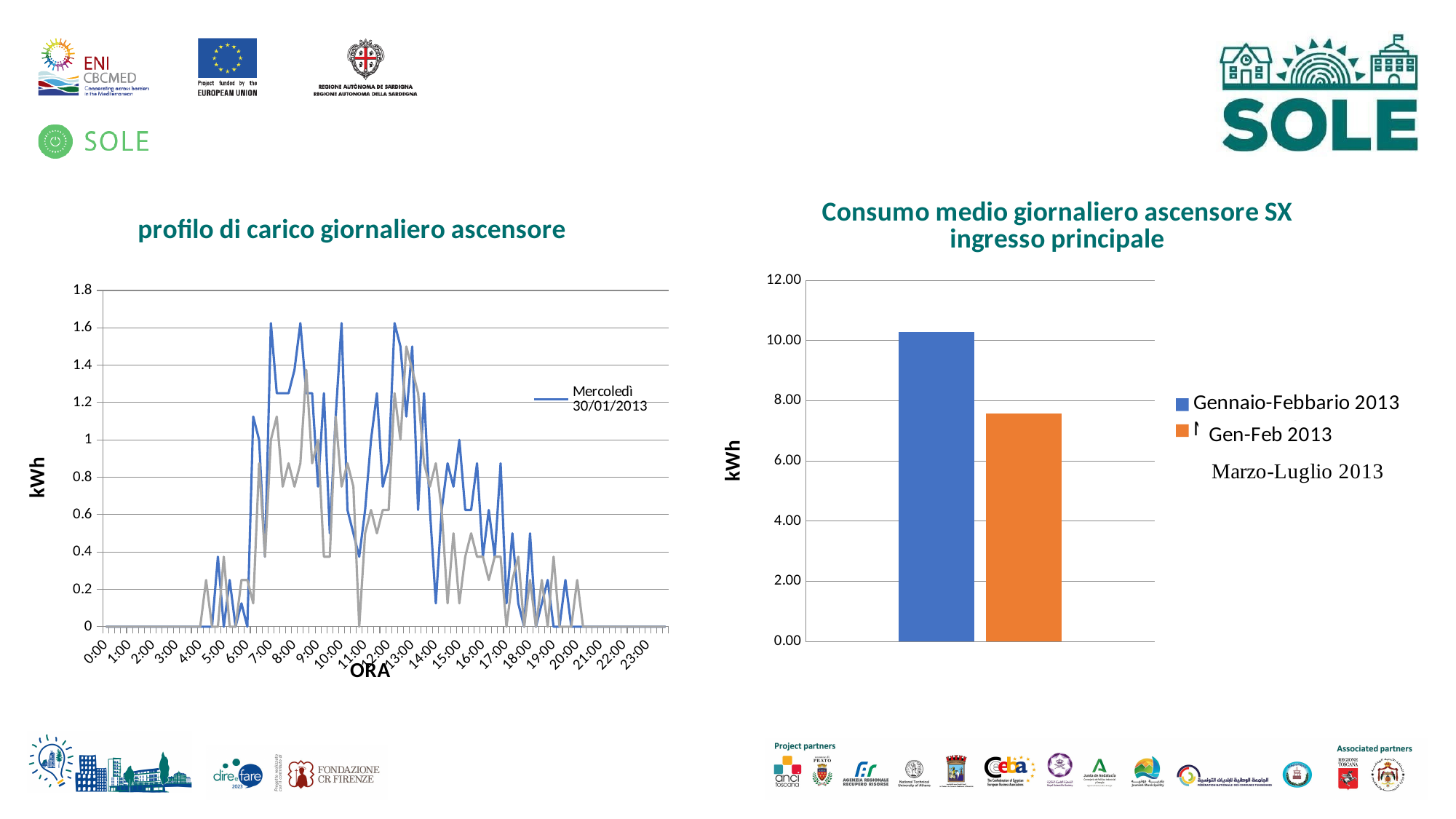
In the chart 'Consumo medio giornaliero ascensore SX ingresso principale', is the value of the blue bar greater or less than 10.00? greater In the chart 'Consumo medio giornaliero ascensore SX ingresso principale', is the value of the orange bar greater or less than 6.00? greater What is the label of the x axis in the chart 'profilo di carico giornaliero ascensore'? ORA In the chart 'Consumo medio giornaliero ascensore SX ingresso principale', is the value of the orange bar greater or less than 8.00? less In the chart 'profilo di carico giornaliero ascensore', does the blue line rise or fall between 6:00 and 7:00? rise In the chart 'Consumo medio giornaliero ascensore SX ingresso principale', which bar is taller, the blue one or the orange one? the blue one What kind of chart is the chart titled 'Consumo medio giornaliero ascensore SX ingresso principale'? bar chart How many bars are plotted in the chart 'Consumo medio giornaliero ascensore SX ingresso principale'? 2 In the chart 'profilo di carico giornaliero ascensore', what is the value of the blue line at 0:00? 0 What kind of chart is the chart titled 'profilo di carico giornaliero ascensore'? line chart What is the label of the y axis in the chart 'Consumo medio giornaliero ascensore SX ingresso principale'? kWh